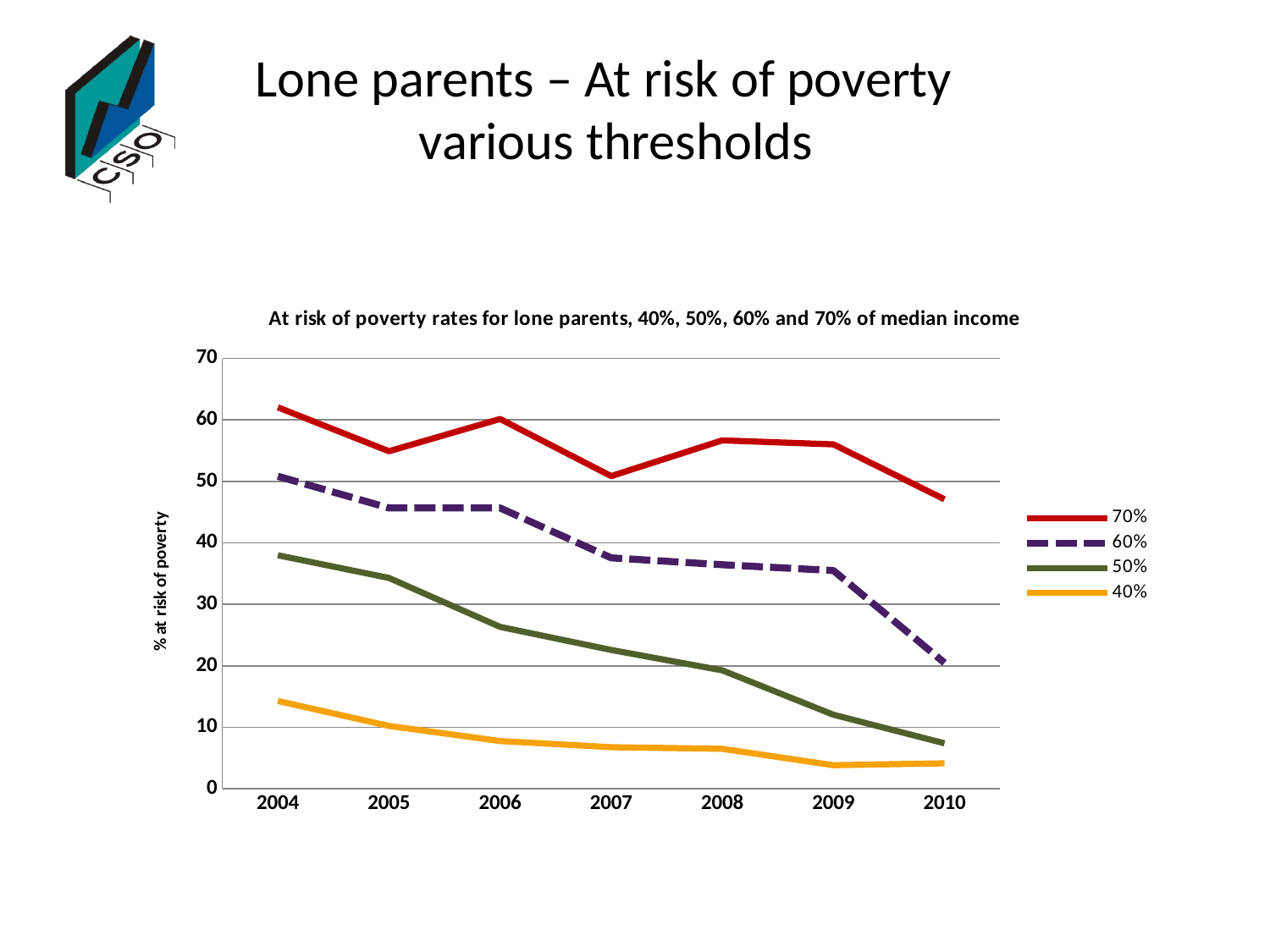
What is the label on the y axis of the chart? % at risk of poverty Is the value for the 40% series in 2009 greater or less than 10? less Is the value for the 50% series in 2004 greater or less than 30? greater How many series does the legend list? 4 In which year is the 50% series at its lowest? 2010 Is the value for the 60% series in 2010 greater or less than 30? less Does the 50% series rise or fall from 2004 to 2010? fall What kind of chart is shown on the slide? line chart How many years are shown along the x axis? 7 Which is larger for the 70% series: the value in 2006 or the value in 2007? 2006 Which series has the highest values across all years? 70%